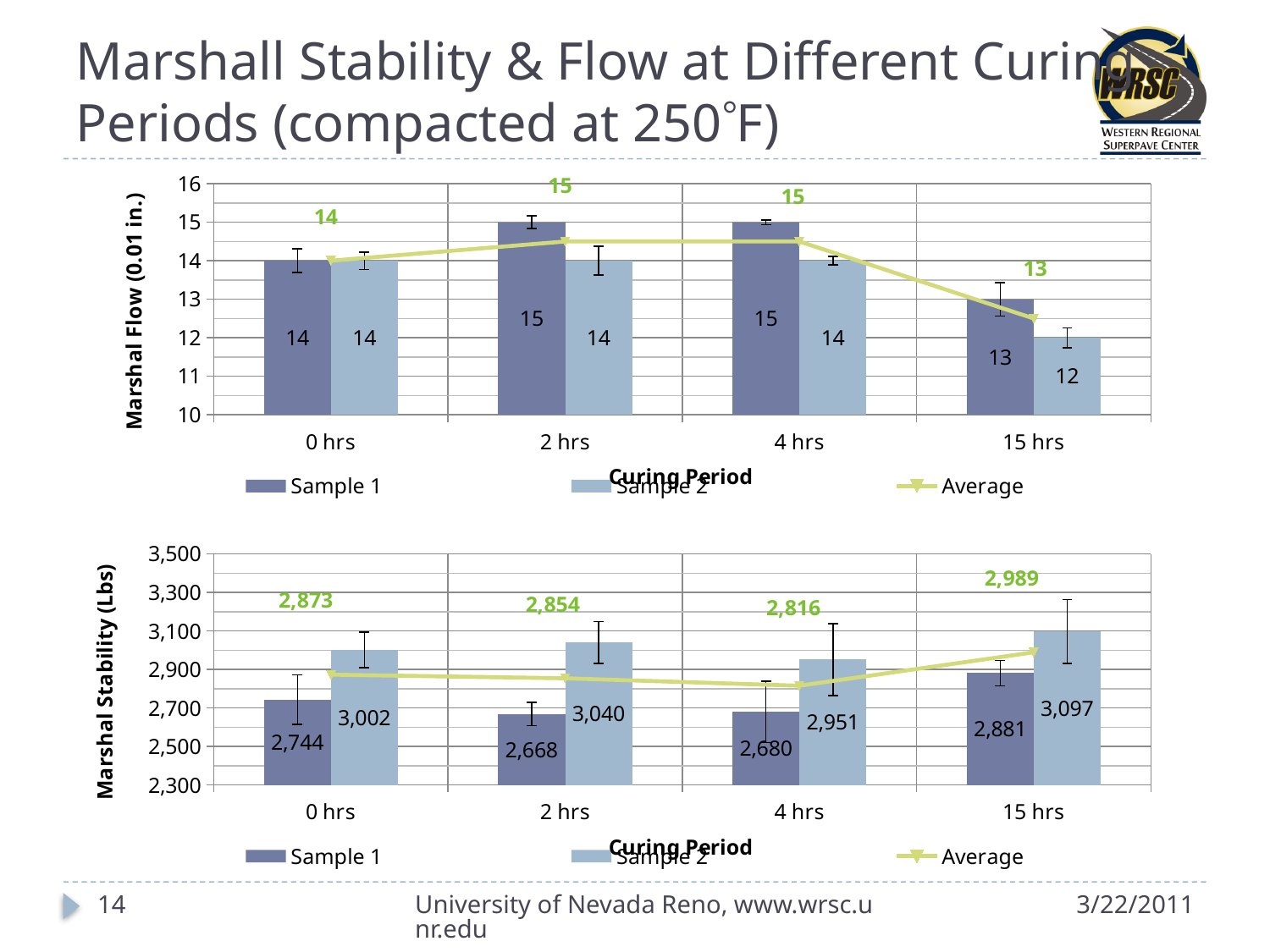
How many curing periods are shown on the x axis of the top chart? 4 In the bottom chart (Marshal Stability), what is the Average value at 4 hrs? 2,816 In the bottom chart (Marshal Stability), which is larger at 15 hrs: Sample 1 or Sample 2? Sample 2 What is the y-axis title of the bottom chart? Marshal Stability (Lbs) In the bottom chart (Marshal Stability), what is the difference between Sample 2 and Sample 1 at 0 hrs? 258 In the top chart (Marshal Flow), what is the value for Sample 2 at 15 hrs? 12 How many series does the legend of the bottom chart list? 3 In the top chart (Marshal Flow), what is the Average value at 15 hrs? 13 In the bottom chart (Marshal Stability), which curing period has the highest Sample 1 value? 15 hrs In the top chart (Marshal Flow), what is the value for Sample 1 at 2 hrs? 15 In the bottom chart (Marshal Stability), what is the value for Sample 2 at 2 hrs? 3,040 In the bottom chart (Marshal Stability), which curing period has the lowest Sample 2 value? 4 hrs